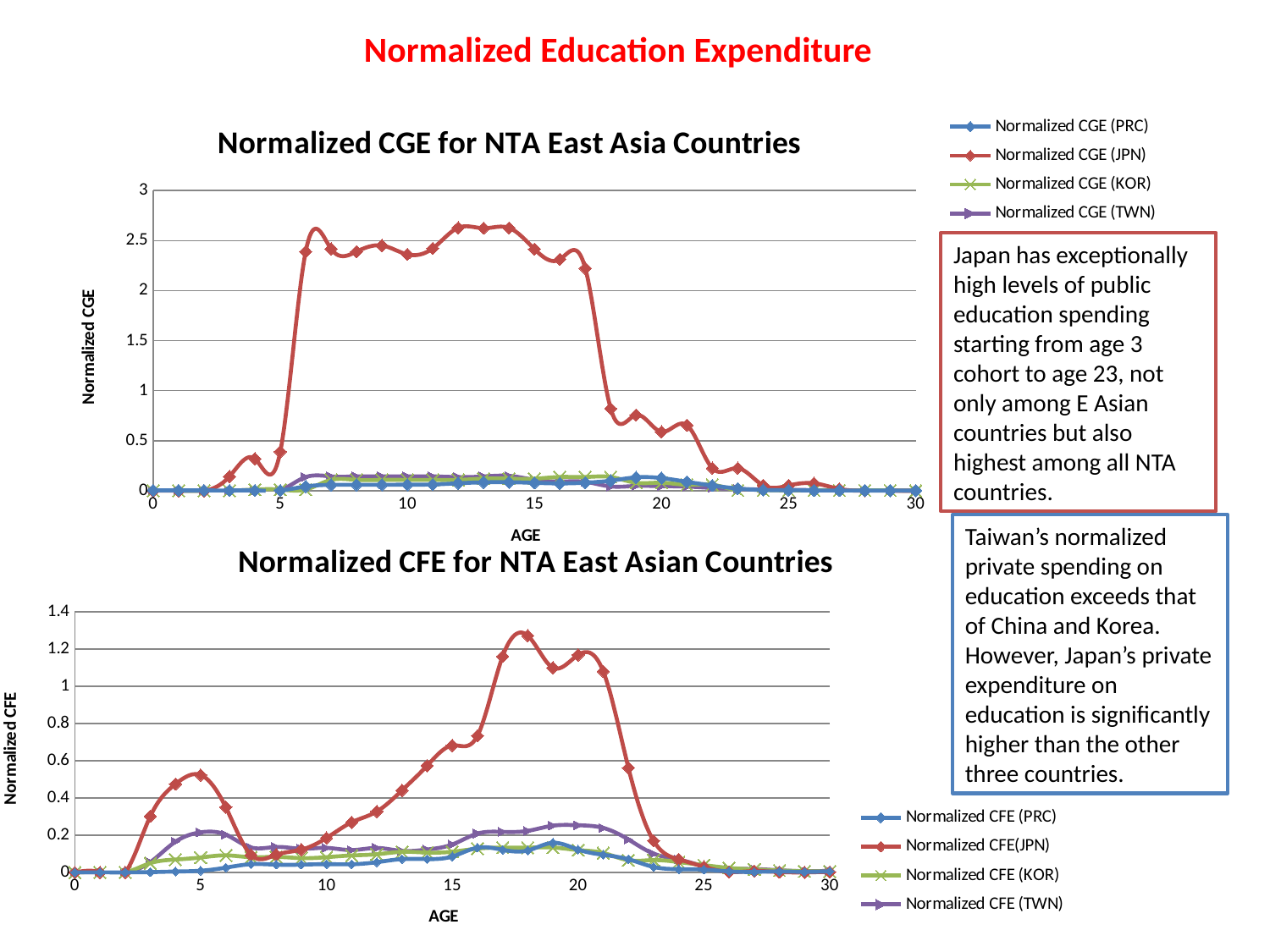
What kind of chart is the top chart titled 'Normalized CGE for NTA East Asia Countries'? line chart What is the label of the x axis on the top chart (Normalized CGE)? AGE In the top chart (Normalized CGE), is the value for JPN at age 20 greater or less than 1? less What is the title of the bottom chart? Normalized CFE for NTA East Asian Countries In the top chart (Normalized CGE), is the value for JPN at age 10 greater or less than 2? greater How many series does the legend of the top chart (Normalized CGE) list? 4 In the bottom chart (Normalized CFE), is the value for JPN at age 18 greater or less than 1? greater How many series does the legend of the bottom chart (Normalized CFE) list? 4 In the bottom chart (Normalized CFE), which country's series reaches the highest values? JPN In the top chart (Normalized CGE), which country's series reaches the highest values? JPN In the bottom chart (Normalized CFE), at age 20, which is larger: the value for JPN or the value for TWN? JPN